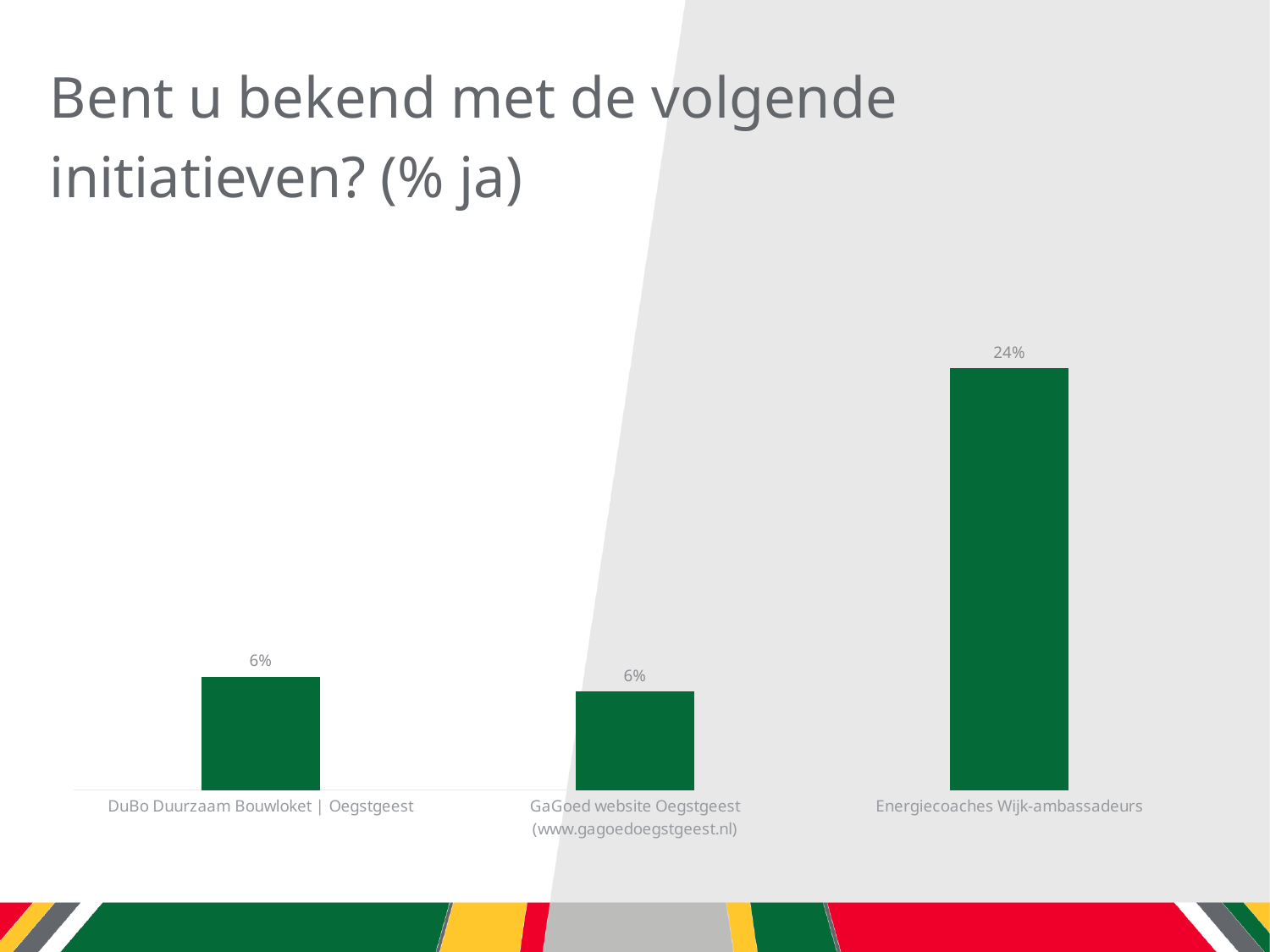
What is the value for DuBo Duurzaam Bouwloket | Oegstgeest? 6% Which is larger: the value for Energiecoaches Wijk-ambassadeurs or the value for GaGoed website Oegstgeest? Energiecoaches Wijk-ambassadeurs Which initiative has the highest percentage of respondents familiar with it? Energiecoaches Wijk-ambassadeurs What is the value for Energiecoaches Wijk-ambassadeurs? 24% How many initiatives are shown in the chart? 3 Which is larger: the value for DuBo Duurzaam Bouwloket | Oegstgeest or the value for Energiecoaches Wijk-ambassadeurs? Energiecoaches Wijk-ambassadeurs What is the difference between the value for Energiecoaches Wijk-ambassadeurs and the value for DuBo Duurzaam Bouwloket | Oegstgeest? 18% What is the difference between the value for Energiecoaches Wijk-ambassadeurs and the value for GaGoed website Oegstgeest? 18% What kind of chart is shown on the slide? Bar chart What is the value for GaGoed website Oegstgeest (www.gagoedoegstgeest.nl)? 6% What is the title of the slide? Bent u bekend met de volgende initiatieven? (% ja) What colour are the bars in the chart? Green